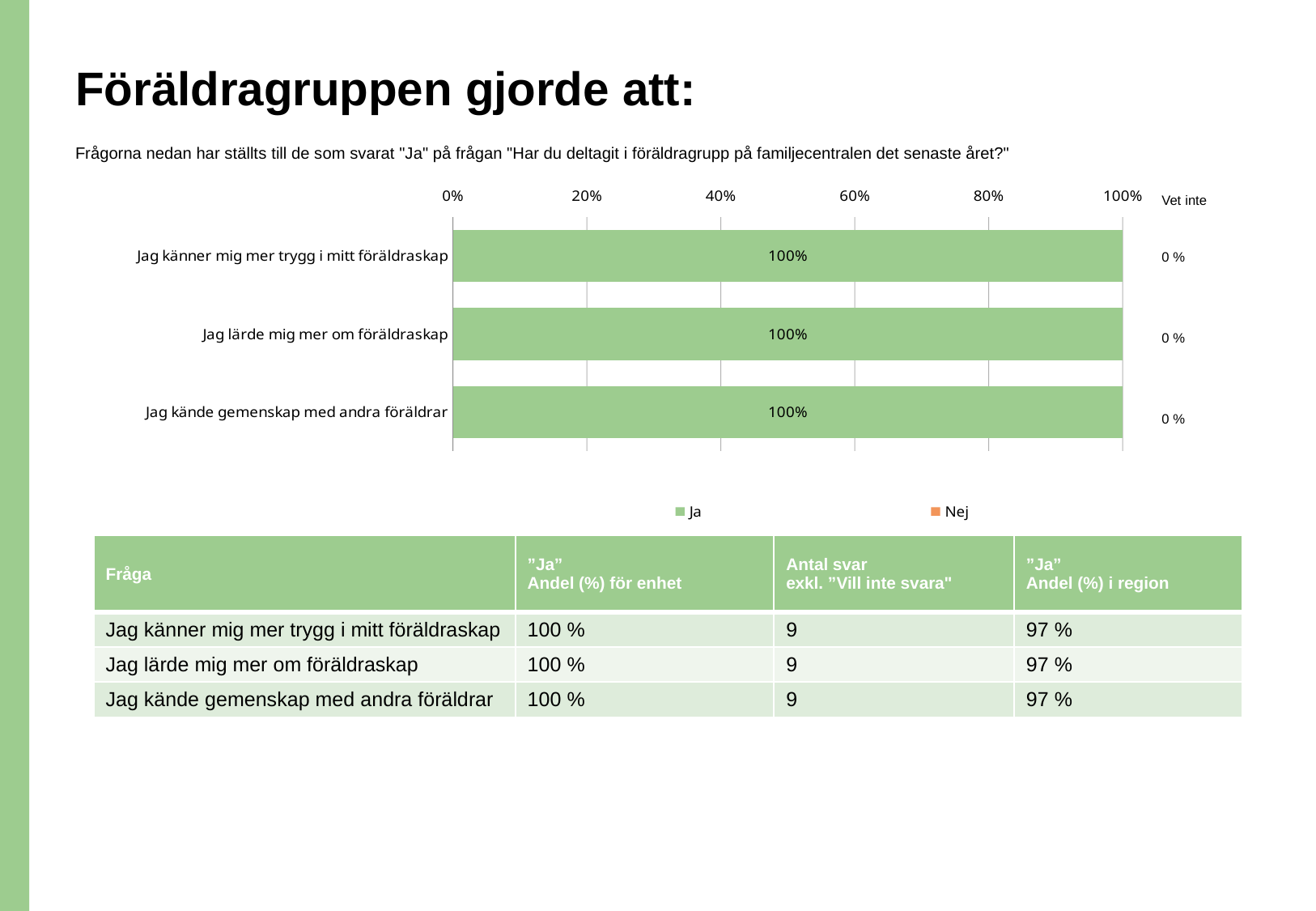
What colour are the bars for the "Ja" series? green What is the "Ja" value for "Jag känner mig mer trygg i mitt föräldraskap"? 100% What is the "Ja" value for "Jag kände gemenskap med andra föräldrar"? 100% How many series does the legend list? 2 What are the two series named in the legend? Ja and Nej Is the "Ja" value for "Jag känner mig mer trygg i mitt föräldraskap" greater or less than 60%? greater What is the "Vet inte" value shown next to the bar for "Jag lärde mig mer om föräldraskap"? 0 % Is the "Ja" value for "Jag kände gemenskap med andra föräldrar" greater or less than 80%? greater How many categories are plotted in the chart? 3 What kind of chart is shown on the slide? bar chart What is the total of the stacked bar for "Jag lärde mig mer om föräldraskap"? 100% What is the "Ja" value for "Jag lärde mig mer om föräldraskap"? 100%